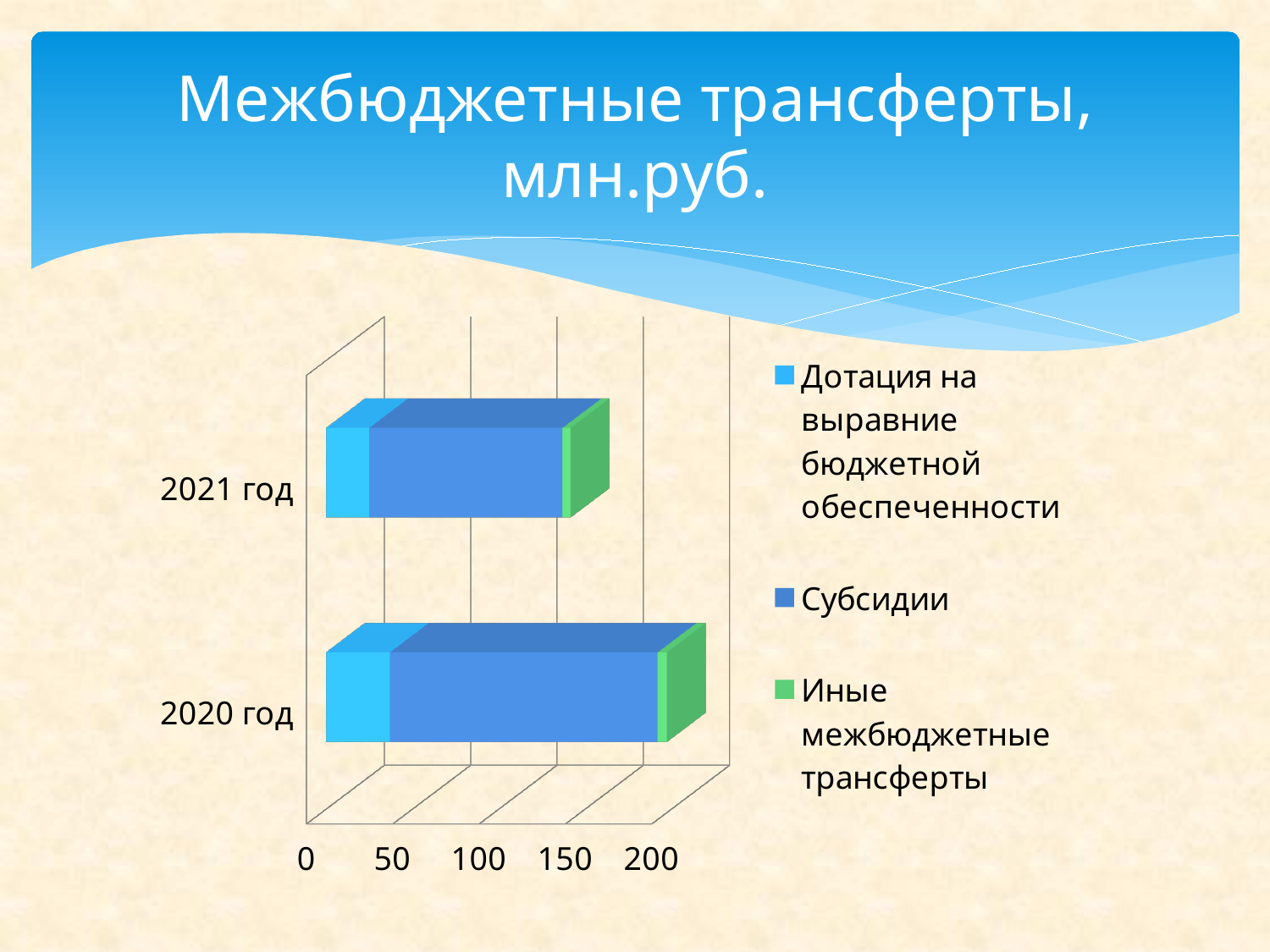
Does the total of the bars rise or fall from 2020 год to 2021 год? fall What is the title of the chart on the slide? Межбюджетные трансферты, млн.руб. Which year has the larger Субсидии segment, 2020 год or 2021 год? 2020 год Is the total bar for 2020 год greater or less than 150? greater How many categories (years) are shown on the chart? 2 Which year has the larger total bar, 2020 год or 2021 год? 2020 год Which series is shown in green in the legend? Иные межбюджетные трансферты Is the total bar for 2021 год greater or less than 100? greater What kind of chart is shown on the slide? bar chart How many series does the legend list? 3 Is the total bar for 2021 год greater or less than 200? less Which year has the smallest total bar? 2021 год